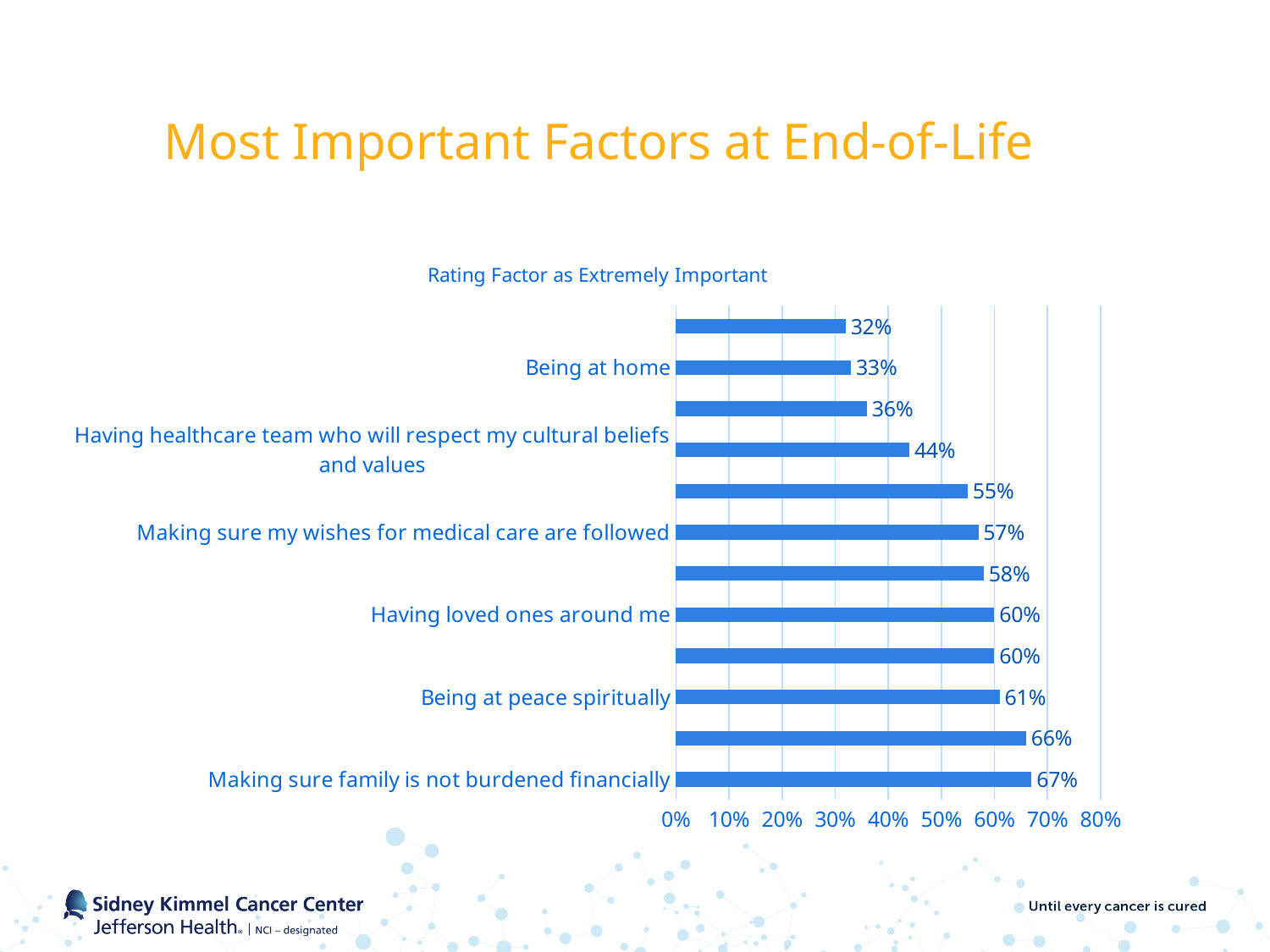
How many bars are plotted on the chart? 12 What kind of chart is shown on the slide? bar chart What is the title of the chart? Rating Factor as Extremely Important Which labeled factor has the highest percentage? Making sure family is not burdened financially What is the value for 'Making sure my wishes for medical care are followed'? 57% What is the value for 'Making sure family is not burdened financially'? 67% What is the lowest value shown on the chart? 32% What is the value for 'Being at peace spiritually'? 61% What percentage rated 'Being at home' as extremely important? 33% What is the value for 'Having loved ones around me'? 60% What is the difference between 'Making sure family is not burdened financially' and 'Being at home'? 34% What is the value for 'Having healthcare team who will respect my cultural beliefs and values'? 44%